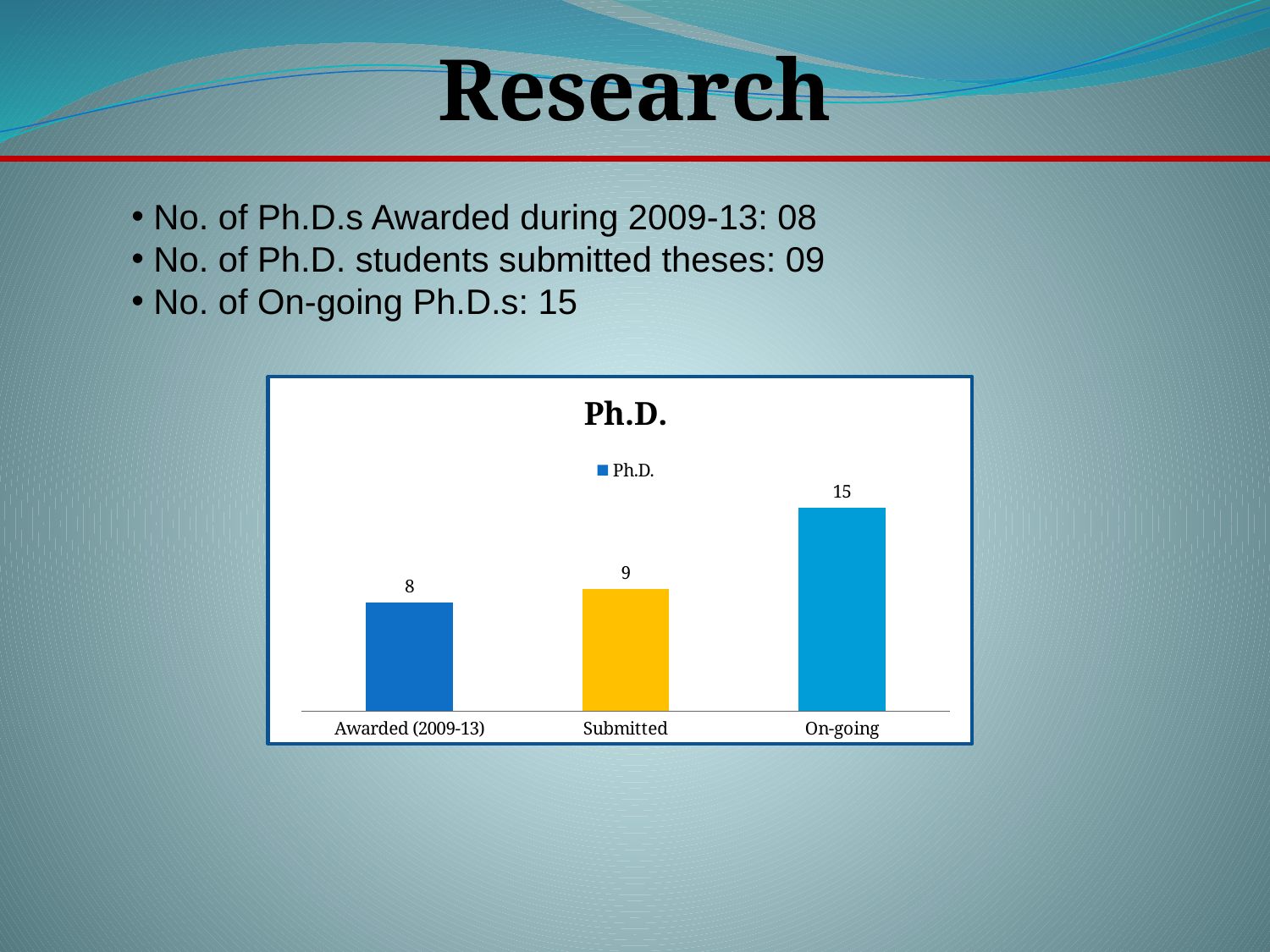
What is the value for Submitted in the Ph.D. chart? 9 What is the value for Awarded (2009-13) in the Ph.D. chart? 8 What kind of chart is shown on the slide? Bar chart What is the difference between the On-going and Awarded (2009-13) values in the Ph.D. chart? 7 Which is larger in the Ph.D. chart, On-going or Submitted? On-going What is the title of the chart on the slide? Ph.D. How many categories are shown in the Ph.D. chart? 3 How many series does the legend of the Ph.D. chart list? 1 Which category has the highest value in the Ph.D. chart? On-going What is the difference between the Submitted and Awarded (2009-13) values in the Ph.D. chart? 1 What is the value for On-going in the Ph.D. chart? 15 Which category has the lowest value in the Ph.D. chart? Awarded (2009-13)